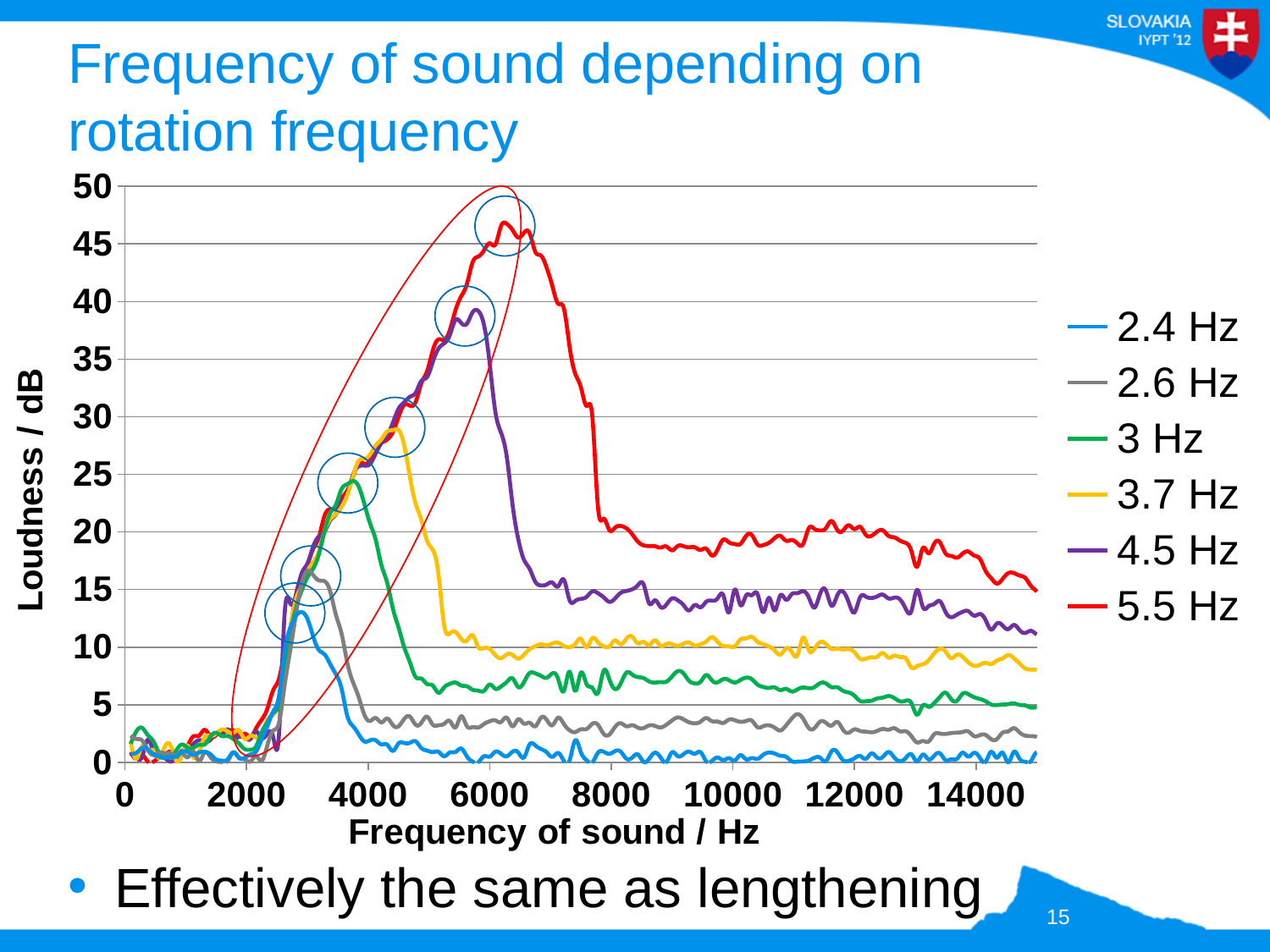
Is the peak loudness of the 3 Hz series greater or less than 20? greater Is the peak loudness of the 2.4 Hz series greater or less than 20? less Which series has the lowest loudness peak? 2.4 Hz Which series reaches the highest loudness peak? 5.5 Hz What is the title of the chart's x axis? Frequency of sound / Hz What kind of chart is shown on the slide? line chart What is the title of the chart's y axis? Loudness / dB Is the peak loudness of the 5.5 Hz series greater or less than 40? greater After its peak, does the loudness of the 5.5 Hz series rise or fall as the sound frequency increases toward 14000 Hz? fall At a sound frequency of 10000 Hz, which series has the larger loudness, 5.5 Hz or 2.4 Hz? 5.5 Hz How many series does the legend list? 6